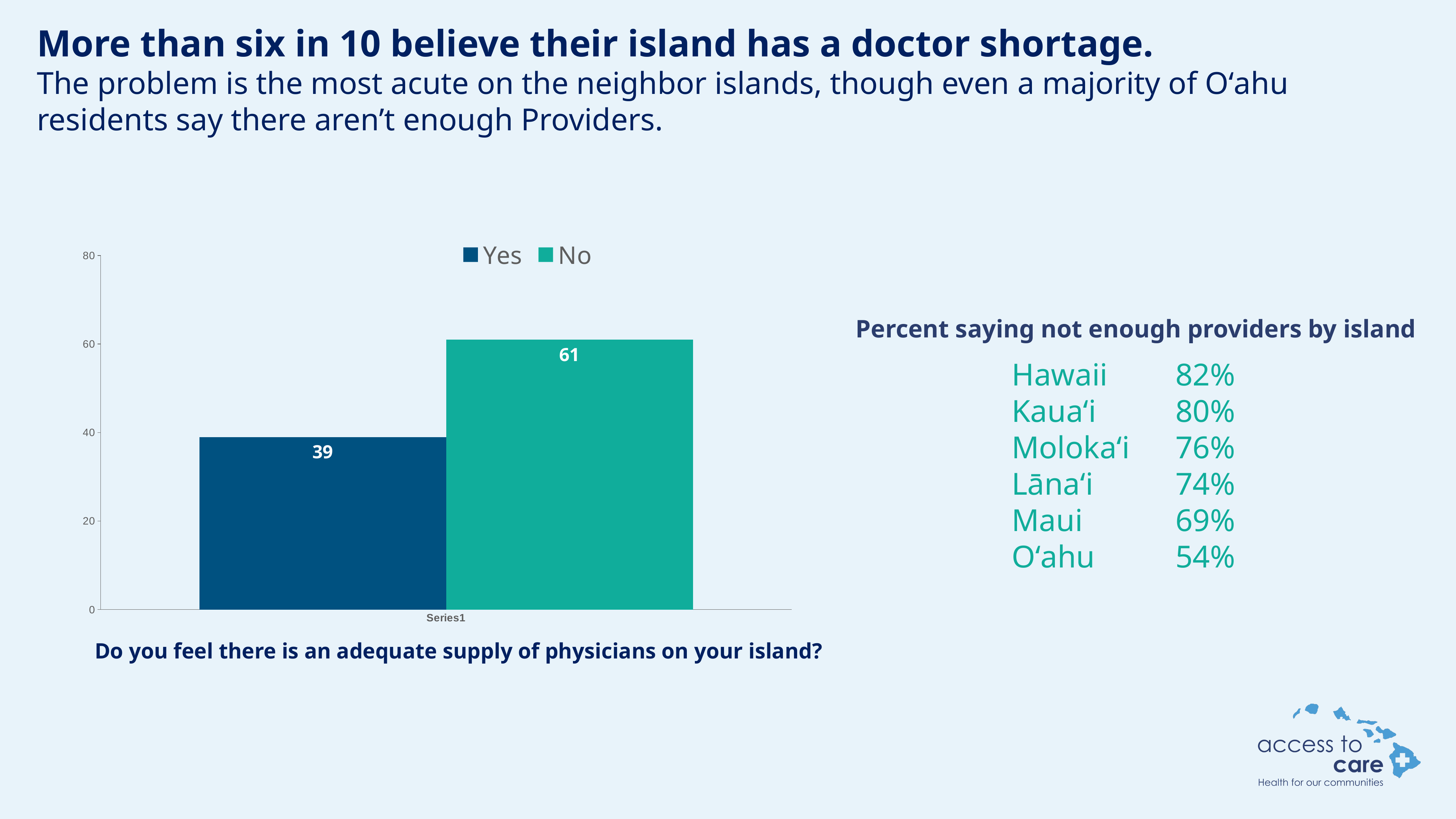
Which series has the lowest value in the bar chart? Yes What is the value of the No bar in the bar chart? 61 What kind of chart is shown on the slide? bar chart How many series does the legend of the bar chart list? 2 What is the difference between the No value and the Yes value in the bar chart? 22 Which series has the highest value in the bar chart? No Is the value for Yes in the bar chart greater or less than 40? less Is the value for No in the bar chart greater or less than 60? greater Which series has the higher value in the bar chart, Yes or No? No What colour is the No bar in the bar chart? teal What is the highest value shown on the vertical axis of the bar chart? 80 What is the value of the Yes bar in the bar chart? 39